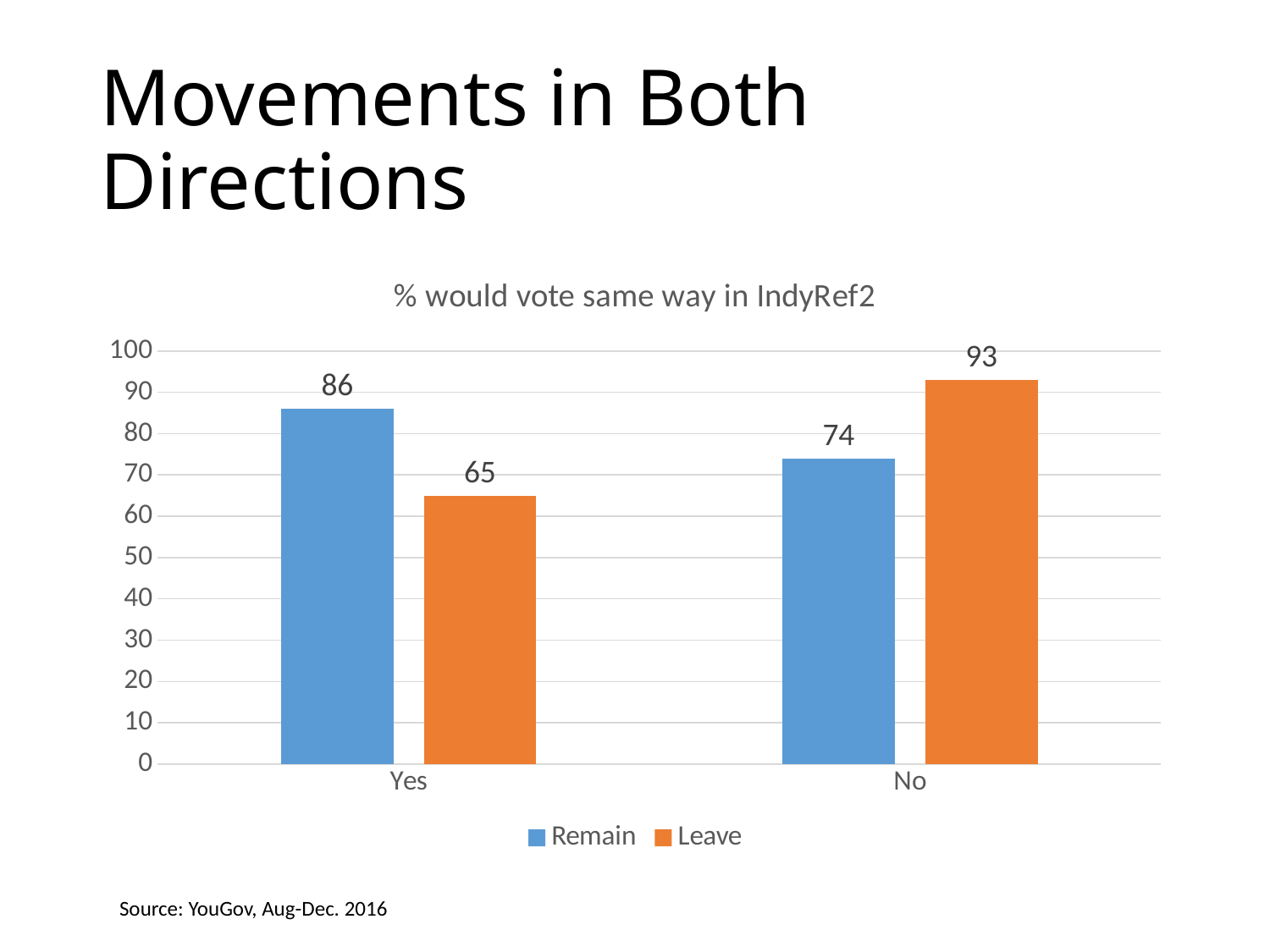
What is the Remain value for the Yes category? 86 How many series does the legend list? 2 What is the Leave value for the Yes category? 65 What is the Remain value for the No category? 74 Which bar has the lowest value on the chart? Leave, Yes Which bar has the highest value on the chart? Leave, No How many categories are shown on the x axis? 2 What is the Leave value for the No category? 93 What is the difference between the Leave and Remain values for the No category? 19 For the No category, which is larger, Remain or Leave? Leave What is the difference between the Remain and Leave values for the Yes category? 21 What type of chart is shown on the slide? Bar chart